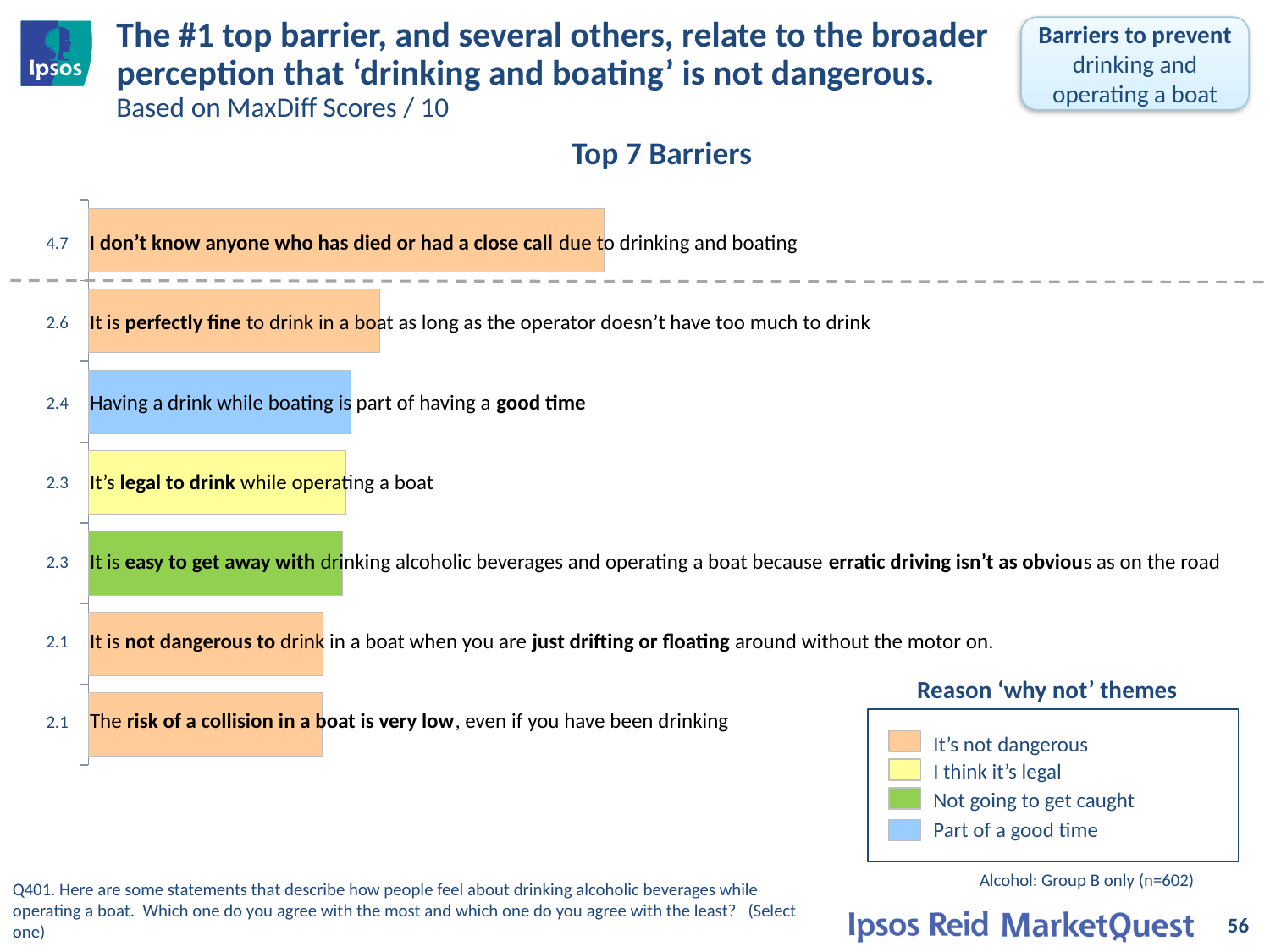
What type of chart is used to show the Top 7 Barriers? Bar chart How many 'why not' themes does the legend list? 4 Which barrier has the highest MaxDiff score in the Top 7 Barriers chart? I don't know anyone who has died or had a close call due to drinking and boating How many barriers are plotted in the Top 7 Barriers chart? 7 What is the MaxDiff score for the barrier 'I don't know anyone who has died or had a close call due to drinking and boating'? 4.7 What is the title of the chart on the slide? Top 7 Barriers What is the lowest score shown in the Top 7 Barriers chart? 2.1 What is the score for 'It's legal to drink while operating a boat'? 2.3 Which 'why not' theme is represented by the green bar? Not going to get caught Which has a higher score: 'It is perfectly fine to drink in a boat as long as the operator doesn't have too much to drink' or 'Having a drink while boating is part of having a good time'? It is perfectly fine to drink in a boat as long as the operator doesn't have too much to drink What is the difference between the top barrier's score (4.7) and the second barrier's score (2.6)? 2.1 What is the score for 'Having a drink while boating is part of having a good time'? 2.4